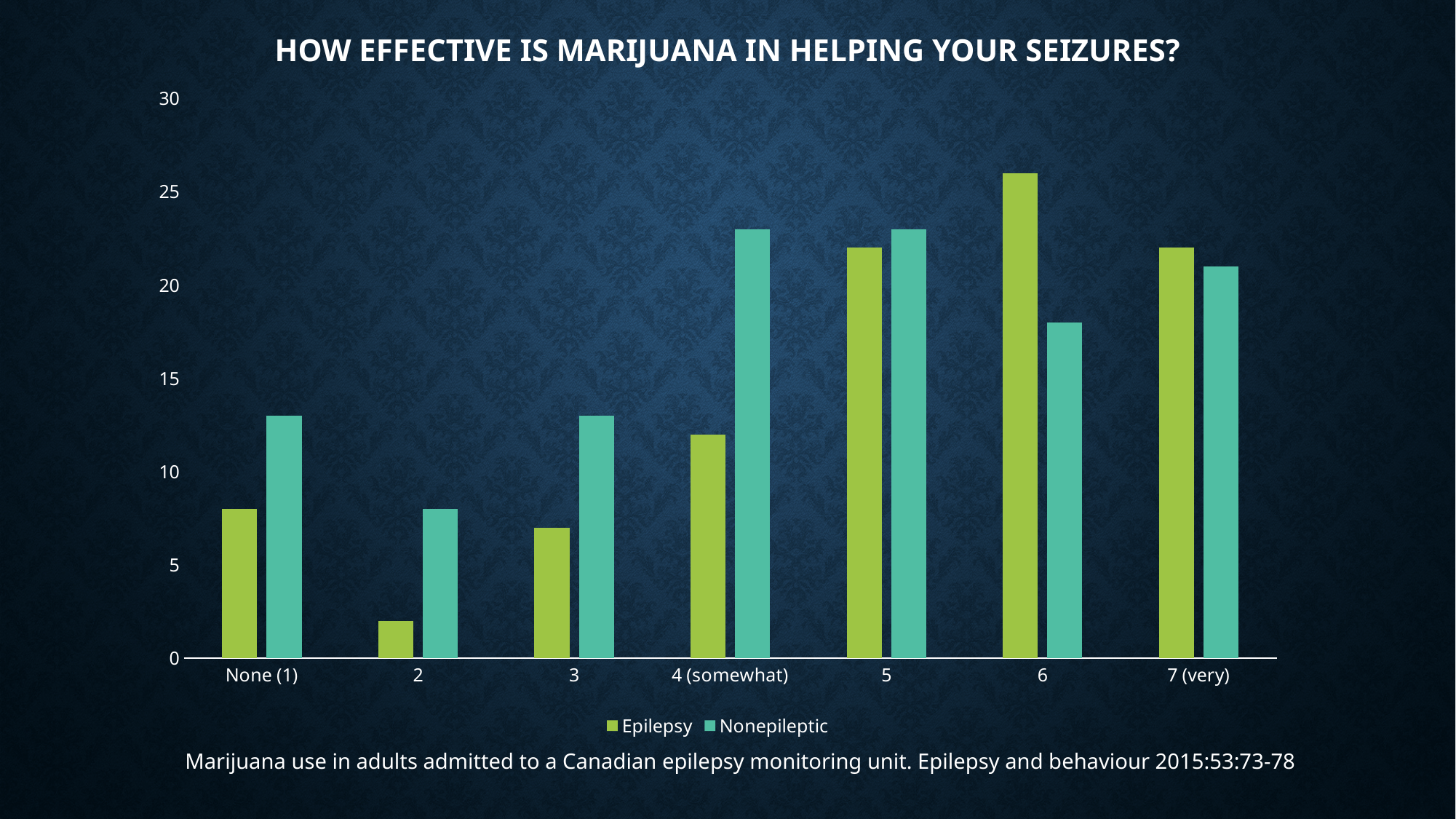
What is the title of the chart? How effective is marijuana in helping your seizures? Which category has the lowest value for the Epilepsy series? 2 What kind of chart is shown on the slide? Bar chart Which category has the lowest value for the Nonepileptic series? 2 How many categories are shown on the x axis? 7 For category 6, which series has the larger value, Epilepsy or Nonepileptic? Epilepsy Is the Epilepsy value for category 6 greater or less than 20? greater How many series does the legend list? 2 Which category has the highest value for the Epilepsy series? 6 For the category None (1), which series has the larger value, Epilepsy or Nonepileptic? Nonepileptic Is the Nonepileptic value for category 4 (somewhat) greater or less than 20? greater Is the Epilepsy value for category 2 greater or less than 5? less